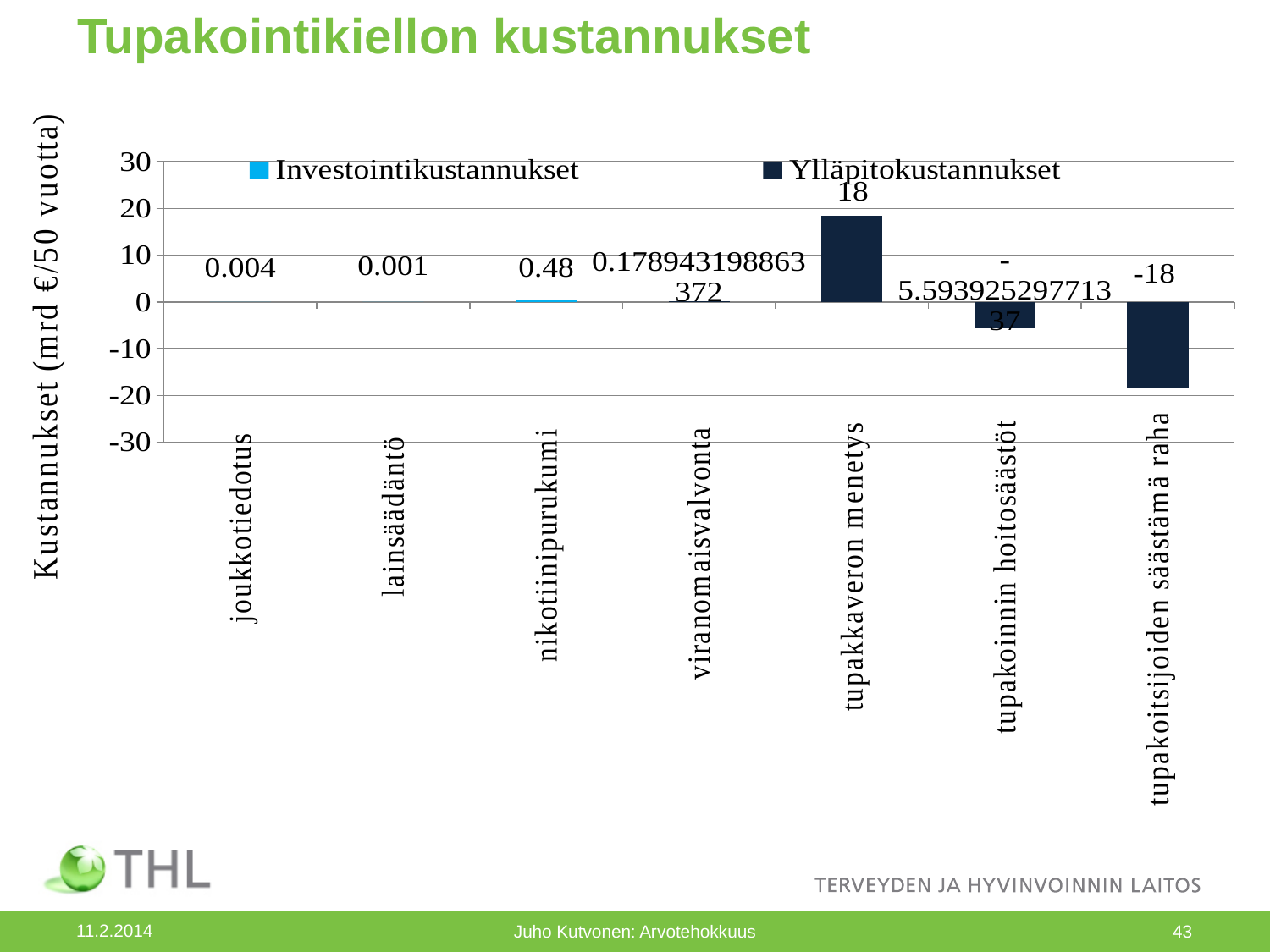
Which category has the lowest value? tupakoitsijoiden säästämä raha Is the value for tupakoinnin hoitosäästöt greater or less than -10? greater What is the value for joukkotiedotus? 0.004 What is the value for nikotiinipurukumi? 0.48 What is the value for lainsäädäntö? 0.001 What type of chart is shown on the slide? bar chart What is the difference between the values for tupakkaveron menetys and nikotiinipurukumi? 17.52 How many categories are shown on the x axis? 7 Which category has the highest value? tupakkaveron menetys What is the value for tupakoitsijoiden säästämä raha? -18 How many series does the legend list? 2 What is the value for tupakkaveron menetys? 18